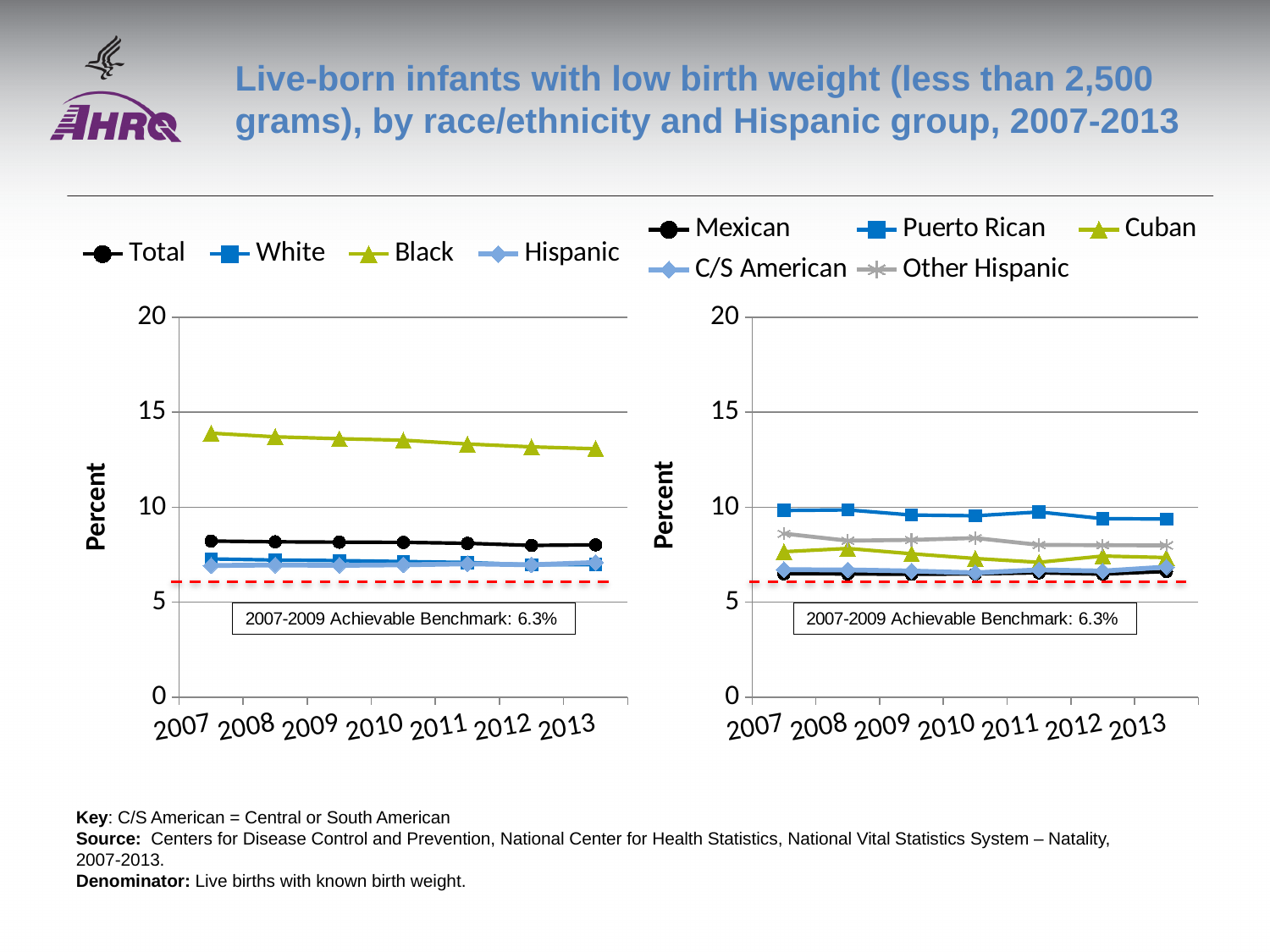
In the right chart, which Hispanic group has the highest percentage of low birth weight infants? Puerto Rican What is the 2007-2009 Achievable Benchmark shown on the charts? 6.3% In the left chart, is the value for Black in 2007 greater or less than 10? greater How many years are shown on the x axis of the left chart? 7 In the right chart, which is larger in 2013, the value for Puerto Rican or the value for Cuban? Puerto Rican In the left chart, is the value for Total in 2013 greater or less than 10? less What kind of chart is the left chart on the slide? line chart In the left chart, which race/ethnicity group has the highest percentage of low birth weight infants? Black In the left chart, does the value for Black rise or fall from 2007 to 2013? fall How many series does the legend of the right chart list? 5 In the right chart, is the value for Mexican in 2007 greater or less than 10? less How many series does the legend of the left chart list? 4